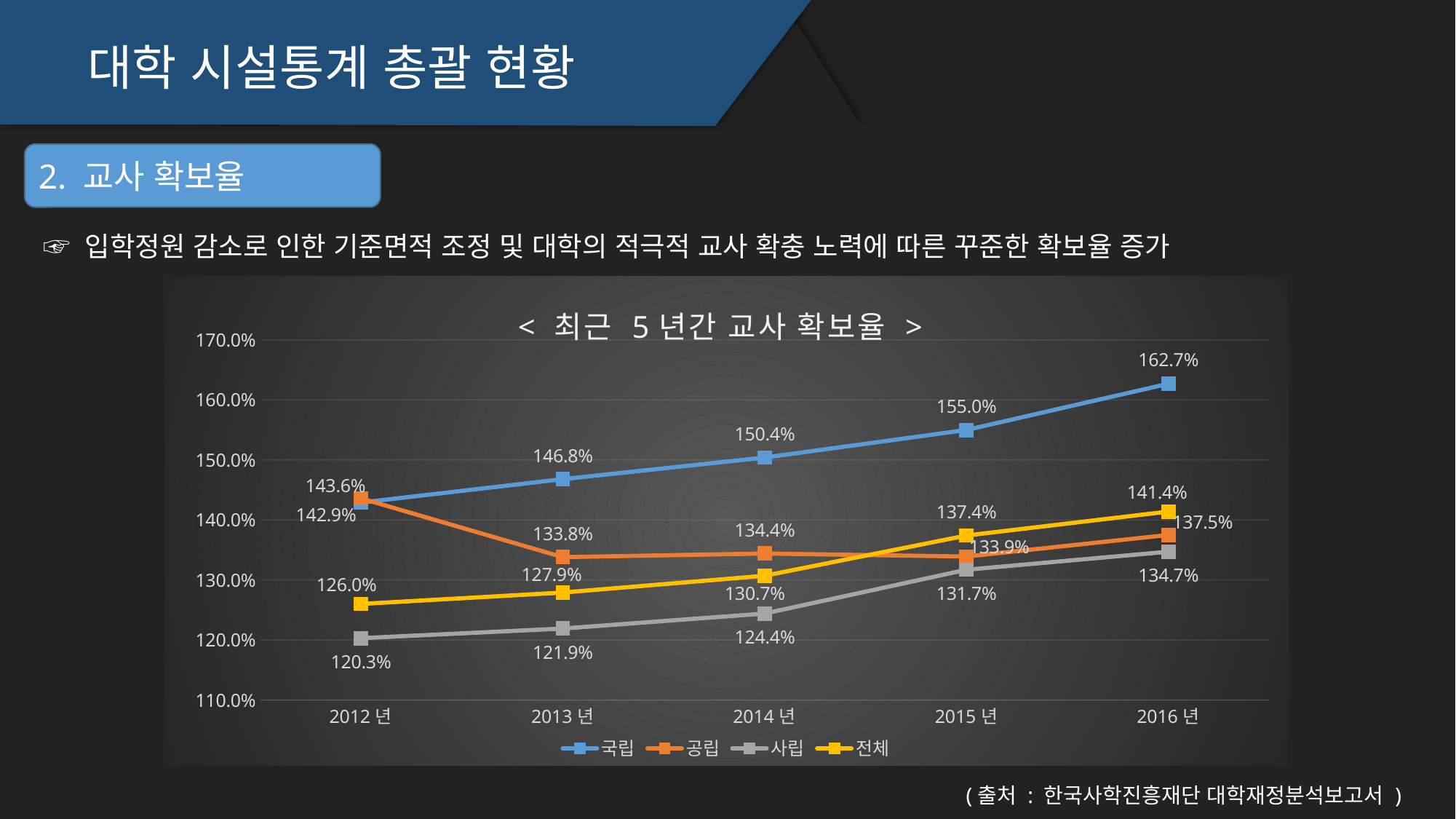
How many series does the legend list? 4 Which series has the lowest value in 2015년? 사립 What is the value for 사립 in 2012년? 120.3% How many years are plotted on the x axis? 5 What type of chart is shown on the slide? line chart What is the value for 국립 in 2016년? 162.7% What is the value for 공립 in 2013년? 133.8% What is the value for 전체 in 2014년? 130.7% What is the difference between the 국립 and 사립 values in 2016년? 28.0% Which is larger in 2012년, the 국립 value or the 공립 value? 공립 Does the 사립 series rise or fall from 2012년 to 2016년? rise In which year is the 국립 value highest? 2016년